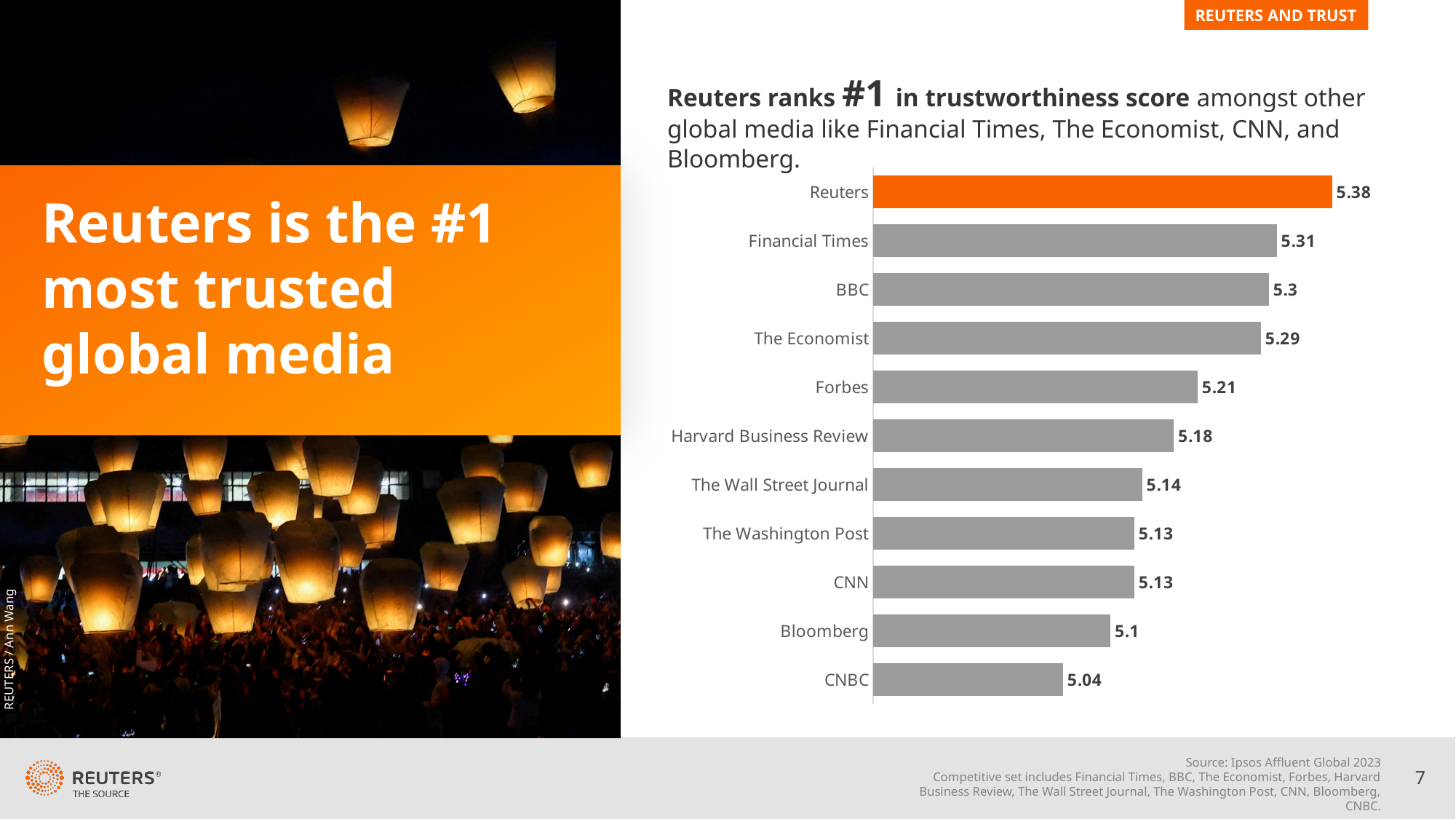
What is the difference between the trustworthiness scores of Reuters and Financial Times? 0.07 What is the trustworthiness score for Harvard Business Review? 5.18 What is the difference between the trustworthiness scores of Forbes and Bloomberg? 0.11 Which has a higher trustworthiness score, The Wall Street Journal or Bloomberg? The Wall Street Journal What is the trustworthiness score for CNBC? 5.04 How many media outlets are shown in the chart? 11 Which media outlet has the highest trustworthiness score? Reuters Which bar in the chart is coloured orange? Reuters What is the trustworthiness score for Reuters? 5.38 What type of chart is shown on the slide? Bar chart What is the trustworthiness score for The Economist? 5.29 Which media outlet has the lowest trustworthiness score? CNBC